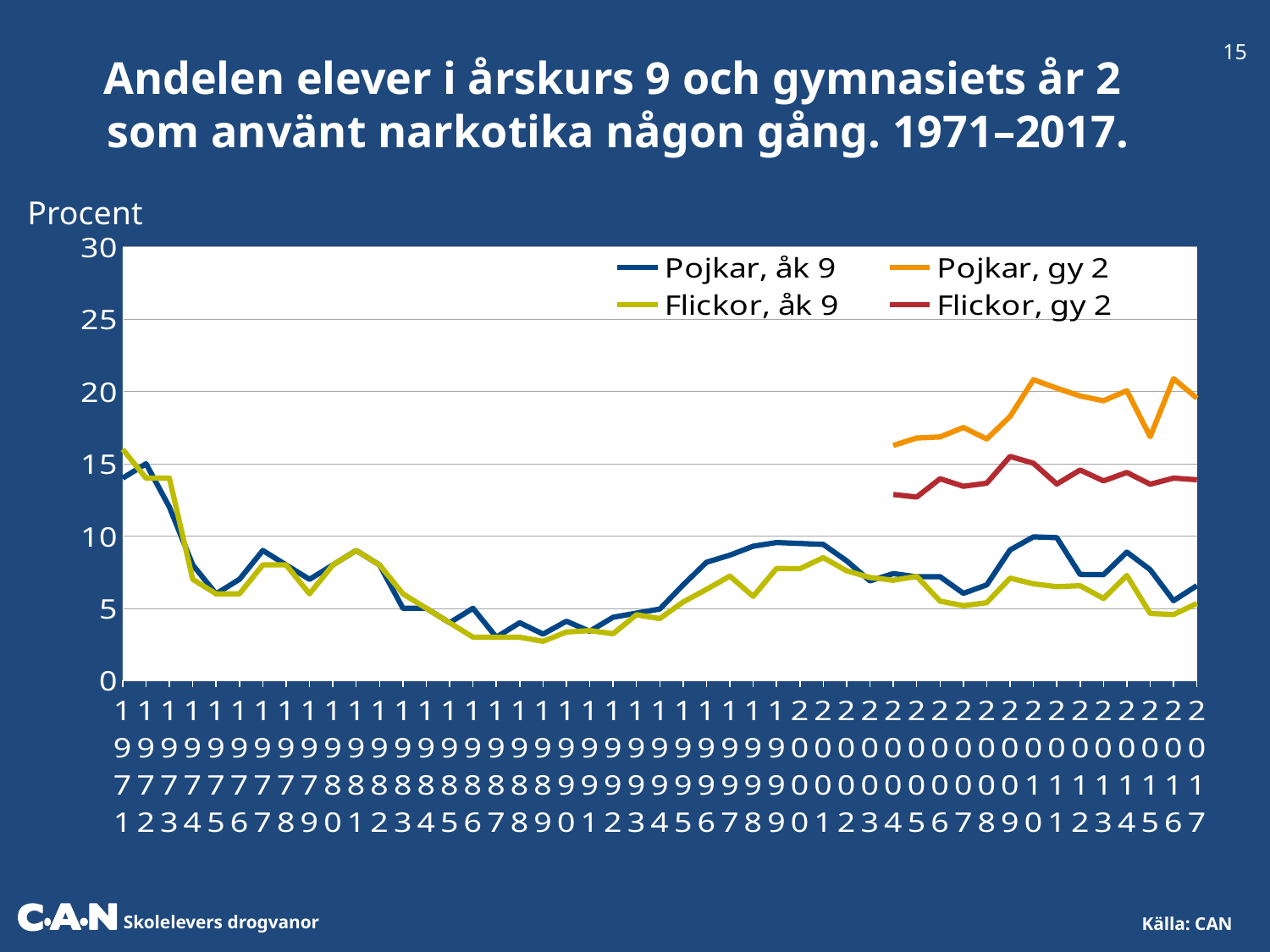
What is the label on the vertical axis of the chart? Procent What kind of chart is shown on the slide? Line chart Is the value for Pojkar, åk 9 in 1971 greater or less than 10? greater Which series has the highest value in 2017? Pojkar, gy 2 Which series is shown in orange in the legend? Pojkar, gy 2 Is the value for Flickor, åk 9 in 1989 greater or less than 5? less How many series does the legend list? 4 In 2017, which is larger: the value for Pojkar, gy 2 or the value for Flickor, gy 2? Pojkar, gy 2 Is the value for Flickor, gy 2 in 2017 greater or less than 10? greater Which series has the lowest value in 2017? Flickor, åk 9 Does the Pojkar, åk 9 series rise or fall between 1971 and 1975? fall